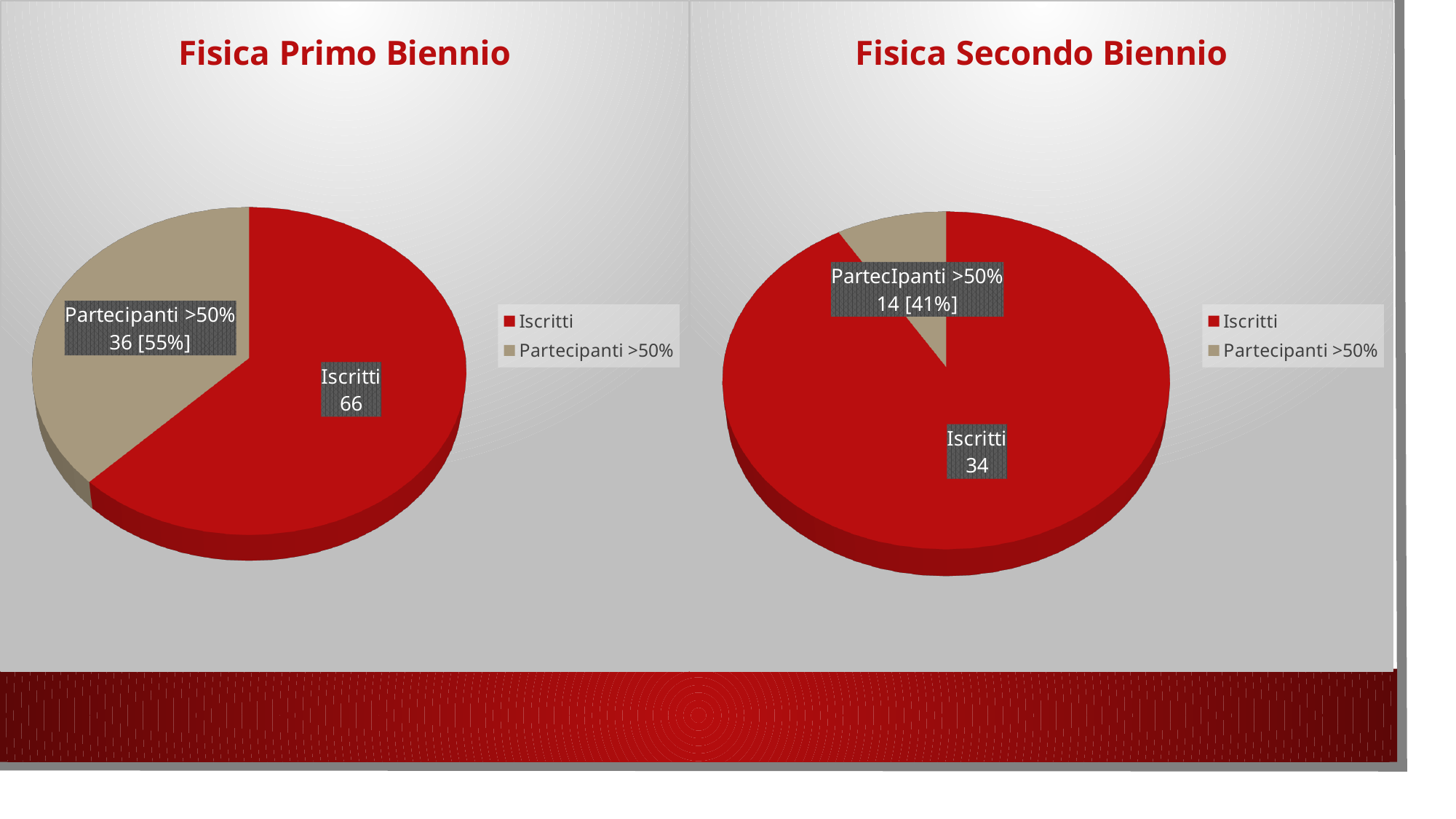
In the Fisica Secondo Biennio chart, what is the difference between the Iscritti value and the Partecipanti >50% count? 20 How many slices does the Fisica Secondo Biennio pie chart have? 2 Is the Iscritti value larger in the Fisica Primo Biennio chart or in the Fisica Secondo Biennio chart? Fisica Primo Biennio In the Fisica Secondo Biennio chart, what value is shown for Partecipanti >50%? 14 [41%] In the Fisica Secondo Biennio chart, what value is shown for Iscritti? 34 How many entries does the legend of the Fisica Primo Biennio chart list? 2 In the Fisica Primo Biennio chart, what value is shown for Partecipanti >50%? 36 [55%] In the Fisica Primo Biennio chart, what is the difference between the Iscritti value and the Partecipanti >50% count? 30 In the Fisica Primo Biennio chart, which slice is the largest? Iscritti In the Fisica Primo Biennio chart, what value is shown for Iscritti? 66 What type of chart is used for Fisica Primo Biennio? Pie chart In the Fisica Secondo Biennio chart, which slice is the smallest? Partecipanti >50%